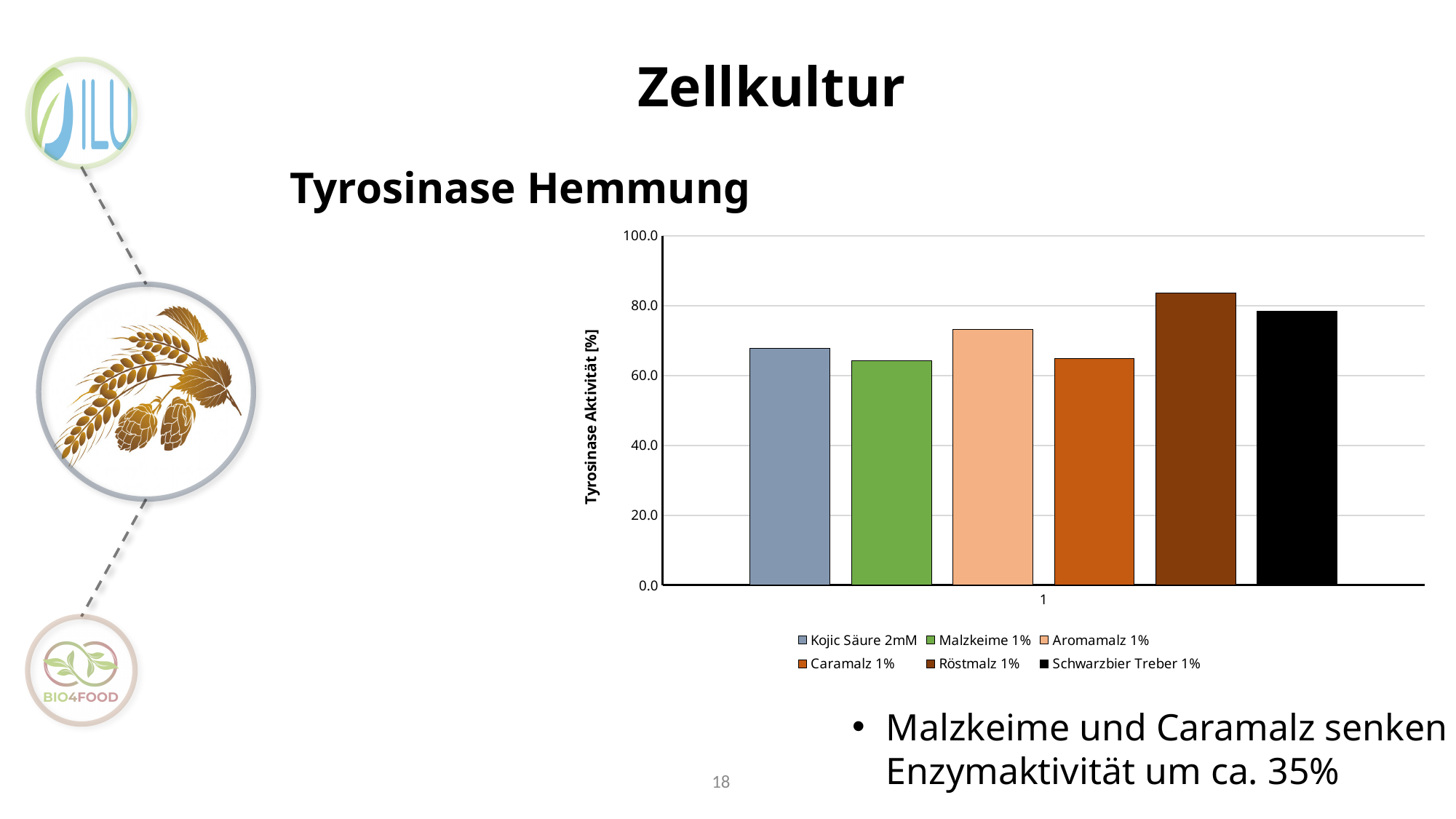
Is the value for Malzkeime 1% greater or less than 80? less What kind of chart is shown on the slide? bar chart Is the value for Aromamalz 1% greater or less than 60? greater Is the value for Röstmalz 1% greater or less than 80? greater Which series is drawn in black? Schwarzbier Treber 1% Which is larger, the value for Röstmalz 1% or for Kojic Säure 2mM? Röstmalz 1% What is the label of the vertical axis? Tyrosinase Aktivität [%] Which series has the highest Tyrosinase Aktivität? Röstmalz 1% Which is larger, the value for Aromamalz 1% or for Malzkeime 1%? Aromamalz 1% How many series does the legend list? 6